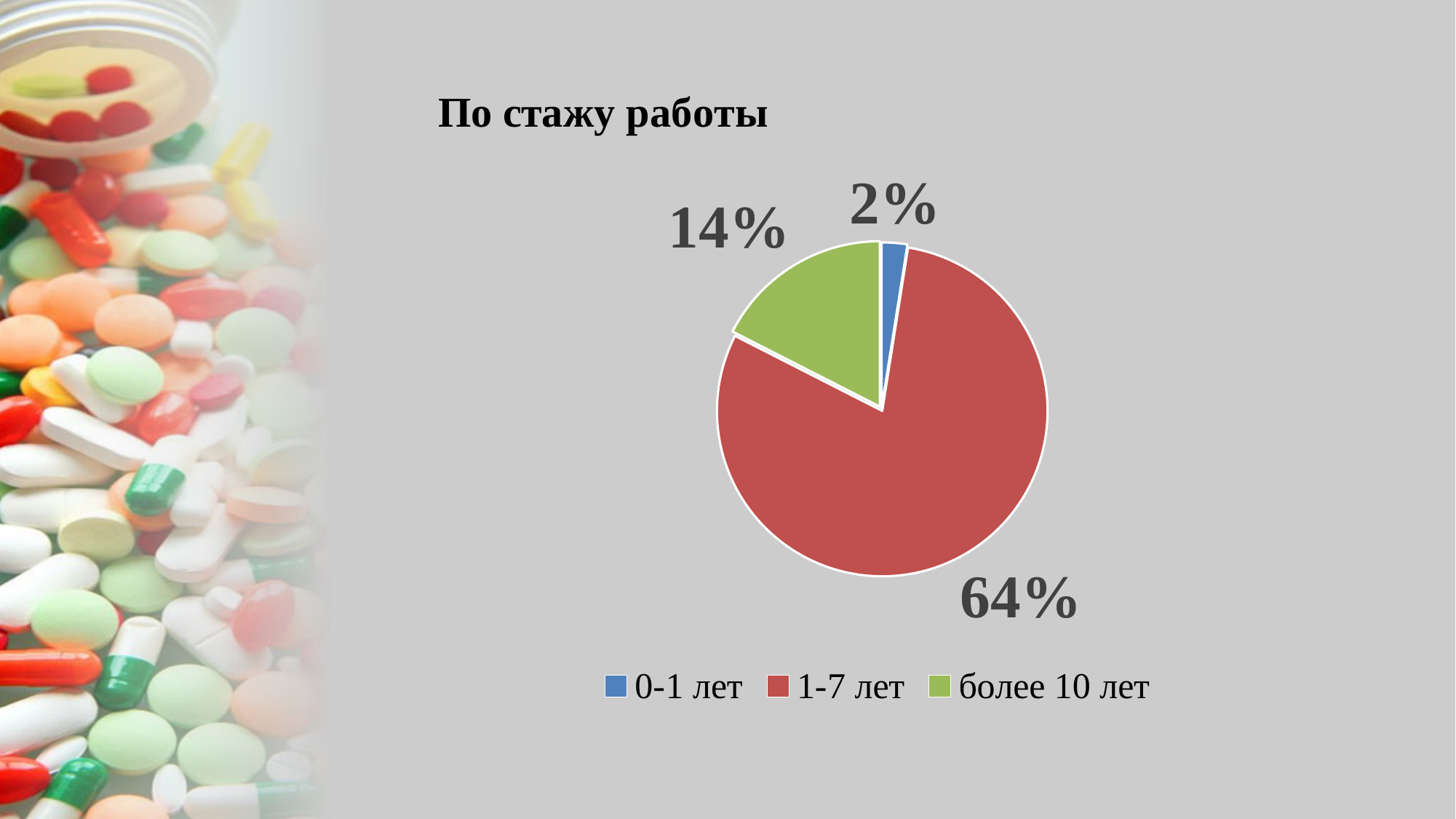
What is the title of the chart? По стажу работы What kind of chart is shown on the slide? Pie chart What colour is the "1-7 лет" slice? Red Which category has the largest slice of the pie? 1-7 лет How many categories does the legend list? 3 What is the difference between the "1-7 лет" and "более 10 лет" percentages? 50% What is the difference between the "более 10 лет" and "0-1 лет" percentages? 12% What percentage is shown for the "0-1 лет" slice? 2% Which category has the smallest slice of the pie? 0-1 лет What percentage is shown for the "1-7 лет" slice? 64% What percentage is shown for the "более 10 лет" slice? 14% Which is larger, the "более 10 лет" slice or the "0-1 лет" slice? более 10 лет